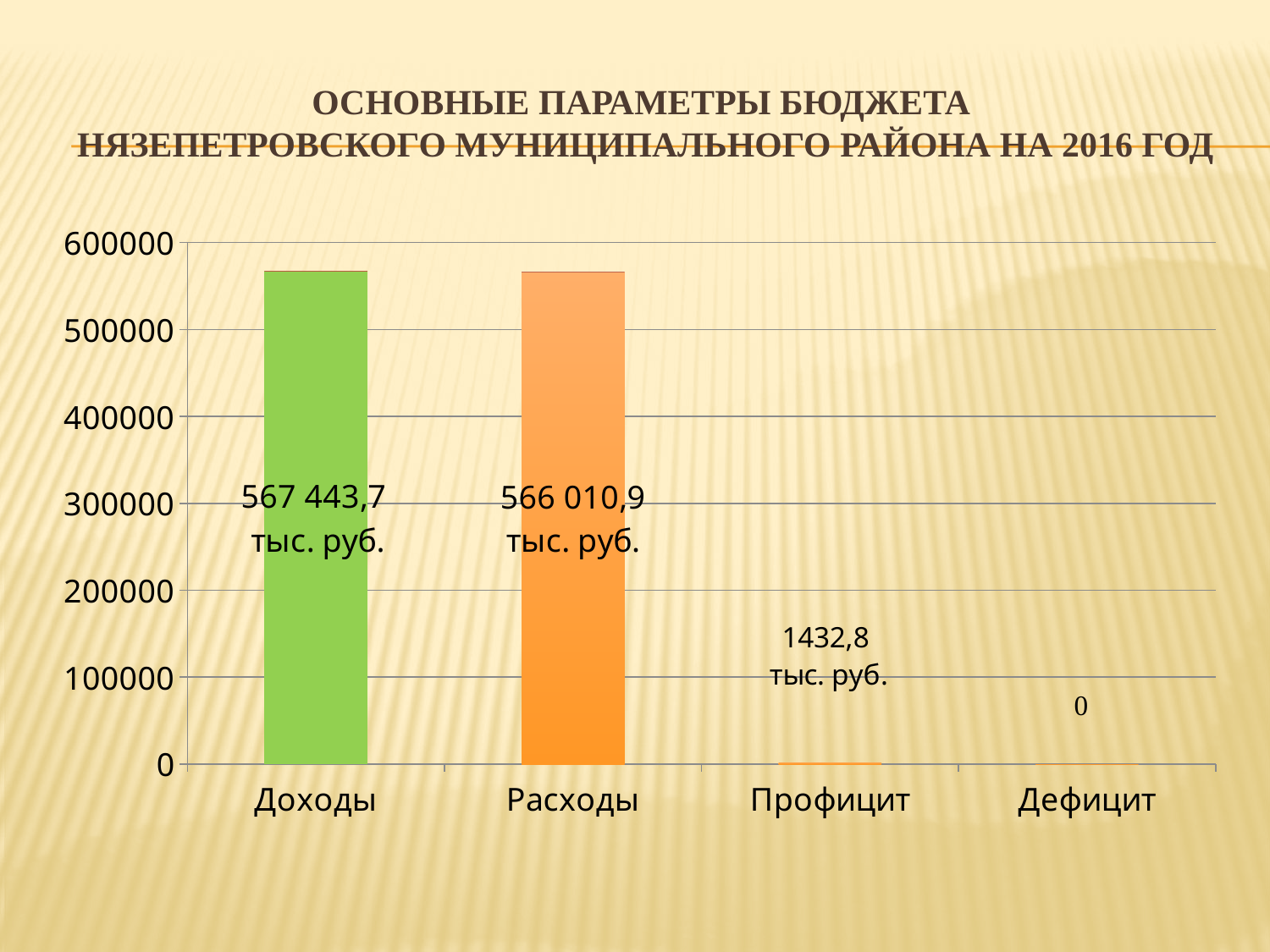
Is the value for Расходы greater or less than 500000? greater What is the value shown for Доходы? 567 443,7 тыс. руб. What kind of chart is shown on the slide? bar chart What is the value shown for Расходы? 566 010,9 тыс. руб. How many categories are shown on the x axis? 4 What colour is the bar for Доходы? green Which is larger, the value for Доходы or the value for Расходы? Доходы Which category has the highest value? Доходы Which category has the lowest value? Дефицит What is the value shown for Профицит? 1432,8 тыс. руб. What is the value shown for Дефицит? 0 What is the difference between the values for Доходы and Расходы? 1432,8 тыс. руб.